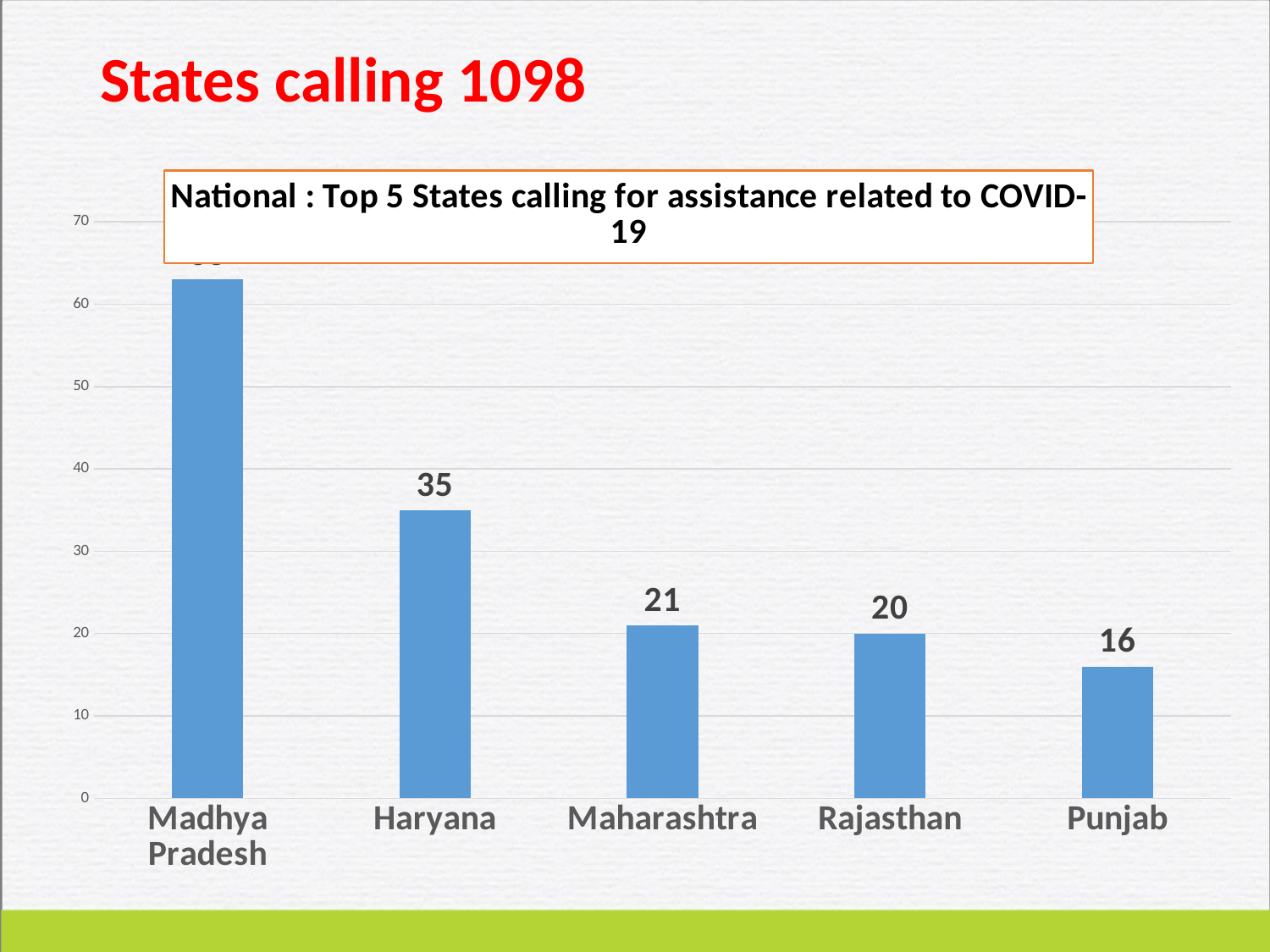
How many states are shown in the chart? 5 Is the value for Madhya Pradesh greater or less than 60? greater What kind of chart is shown on the slide? bar chart What is the value for Rajasthan? 20 What is the value for Maharashtra? 21 What is the value for Punjab? 16 What is the value for Haryana? 35 What is the difference between the values for Haryana and Maharashtra? 14 Which state has the highest value? Madhya Pradesh Which state has the lowest value? Punjab What is the difference between the values for Rajasthan and Punjab? 4 Which is larger, the value for Haryana or the value for Punjab? Haryana